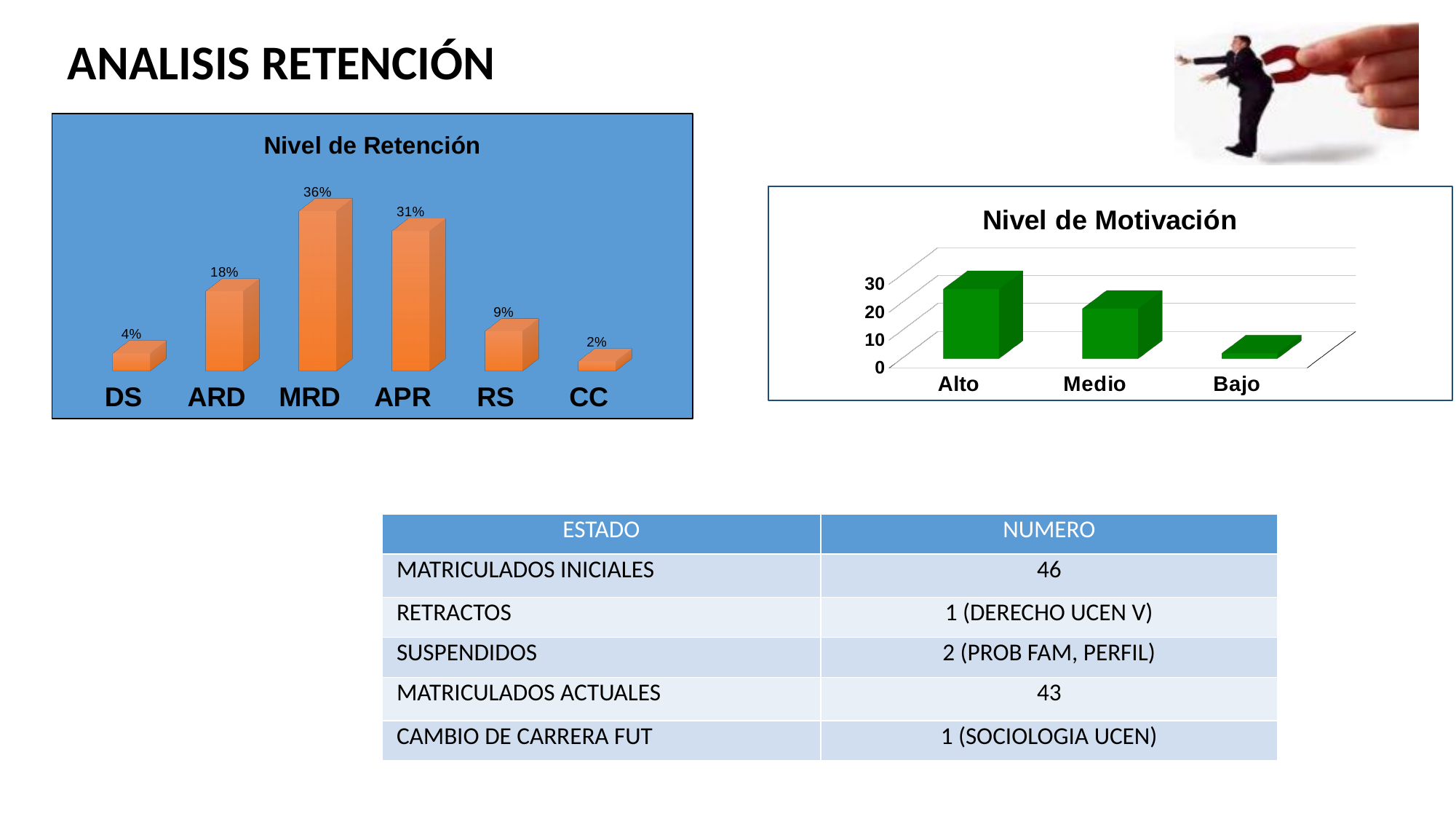
In the Nivel de Retención chart, what is the difference between the values for MRD and APR? 5% In the Nivel de Motivación chart, which category has the highest value? Alto In the Nivel de Retención chart, what is the value for APR? 31% In the Nivel de Retención chart, which is larger, the value for ARD or the value for RS? ARD In the Nivel de Retención chart, which category has the lowest value? CC In the Nivel de Motivación chart, is the value for Alto greater or less than 20? greater What kind of chart is the Nivel de Motivación chart? Bar chart How many categories are shown in the Nivel de Retención chart? 6 In the Nivel de Retención chart, what is the value for DS? 4% In the Nivel de Motivación chart, is the value for Bajo greater or less than 10? less In the Nivel de Retención chart, what is the value for MRD? 36% In the Nivel de Retención chart, which category has the highest value? MRD